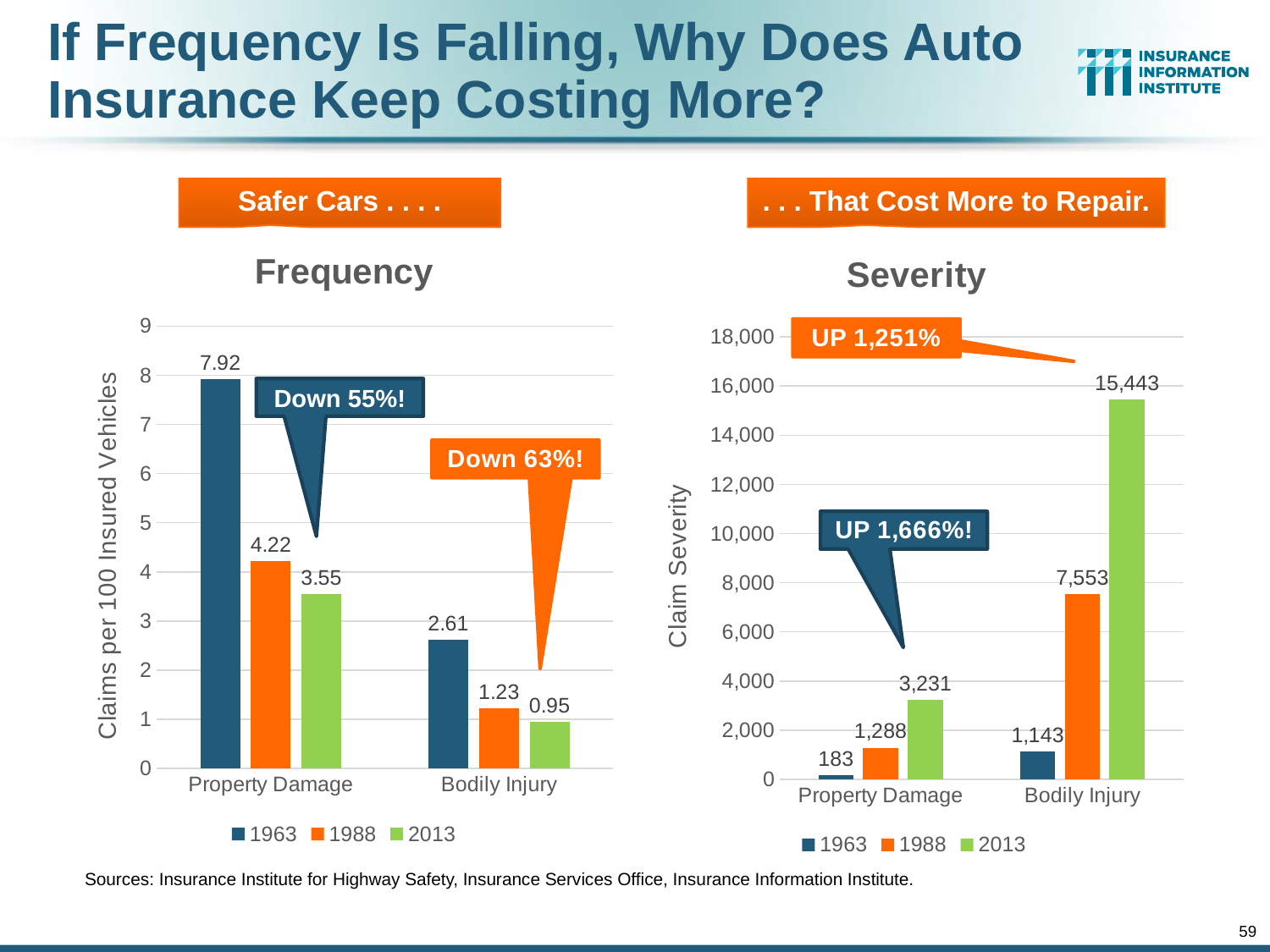
In the Frequency chart, which category and year has the lowest value? Bodily Injury, 2013 In the Frequency chart, do the values for Property Damage rise or fall from 1963 to 2013? fall In the Frequency chart, what is the value for Bodily Injury in 2013? 0.95 In the Severity chart, what is the claim severity for Property Damage in 1963? 183 In the Severity chart, which category and year has the highest claim severity? Bodily Injury, 2013 In the Frequency chart, what is the difference between the 1963 and 1988 values for Property Damage? 3.70 What kind of chart is the Severity chart? bar chart In the Severity chart, what is the claim severity for Bodily Injury in 2013? 15,443 In the Severity chart, what is the difference between the 2013 and 1988 values for Bodily Injury? 7,890 In the Frequency chart, what is the value for Property Damage in 1963? 7.92 How many series does the legend of the Frequency chart list? 3 In the Severity chart, which is larger: Property Damage in 2013 or Bodily Injury in 1988? Bodily Injury in 1988